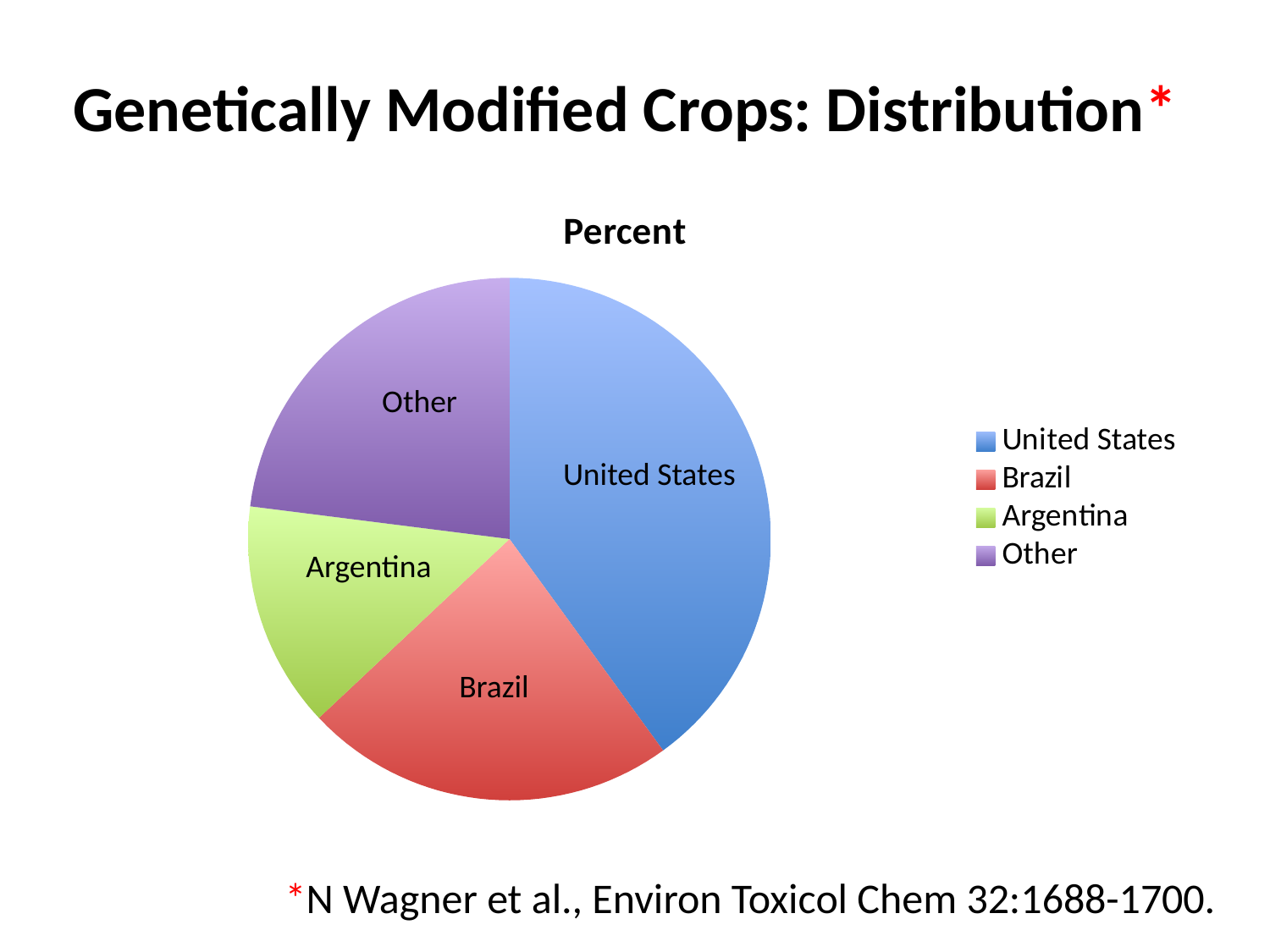
What colour is the Argentina slice? Green How many slices does the pie chart have? 4 Which slice is larger, Argentina or United States? United States Which slice is larger, United States or Brazil? United States What is the title of the chart? Percent Which category has the largest slice of the pie? United States How many entries does the legend list? 4 What kind of chart is shown on the slide? Pie chart Which slice is larger, Brazil or Argentina? Brazil Which category has the smallest slice of the pie? Argentina